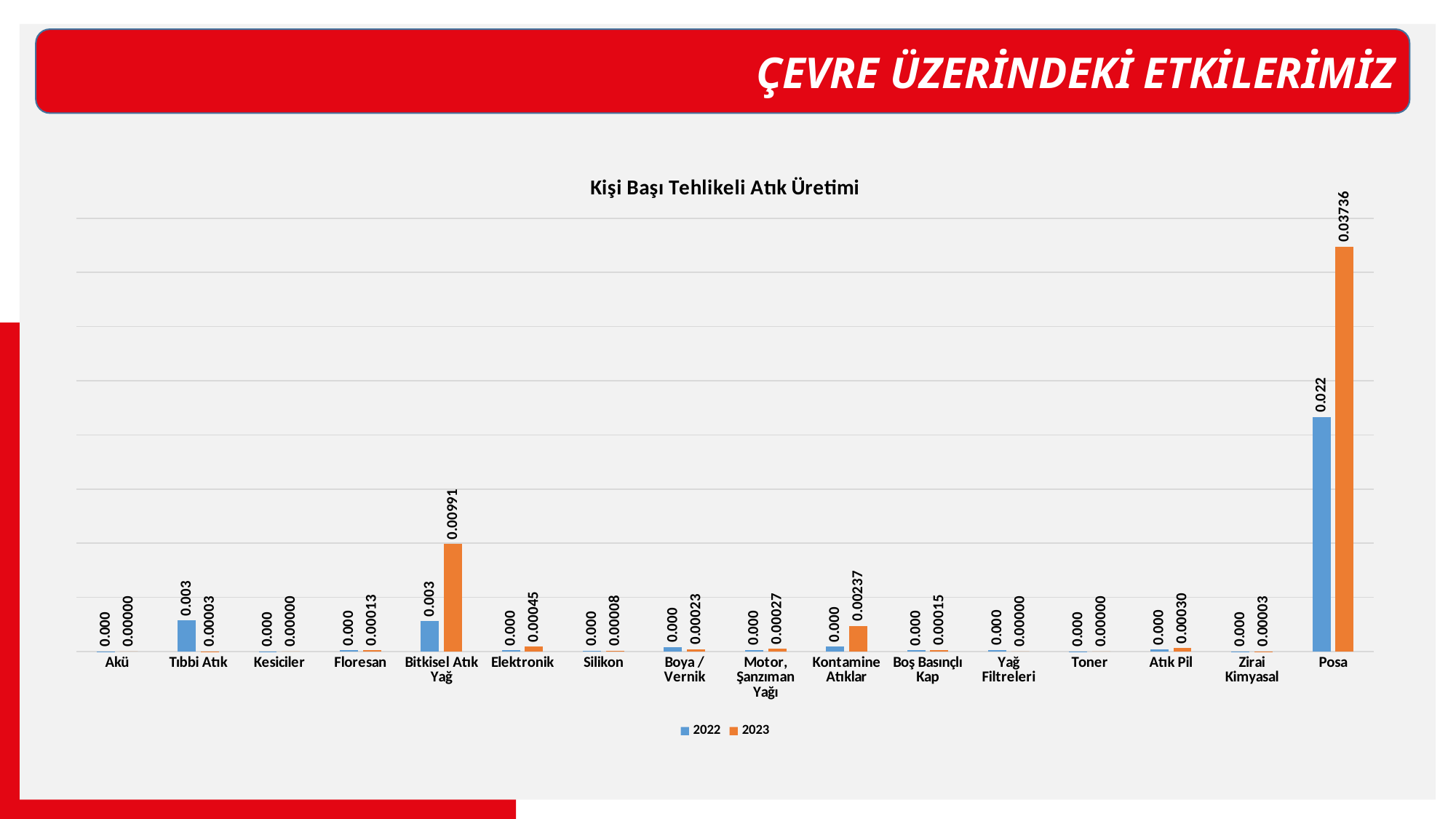
What is the 2022 value for Posa? 0.022 Which series is shown in orange in the legend? 2023 What is the 2023 value for Posa? 0.03736 What is the title of the chart? Kişi Başı Tehlikeli Atık Üretimi What is the 2023 value for Bitkisel Atık Yağ? 0.00991 How many series does the legend list? 2 What is the 2023 value for Kontamine Atıklar? 0.00237 How many categories are shown on the x axis? 16 Which category has the highest 2023 value? Posa What is the difference between the 2023 and 2022 values for Posa? 0.01536 For Bitkisel Atık Yağ, which is larger: the 2022 value or the 2023 value? 2023 What kind of chart is shown on the slide? bar chart